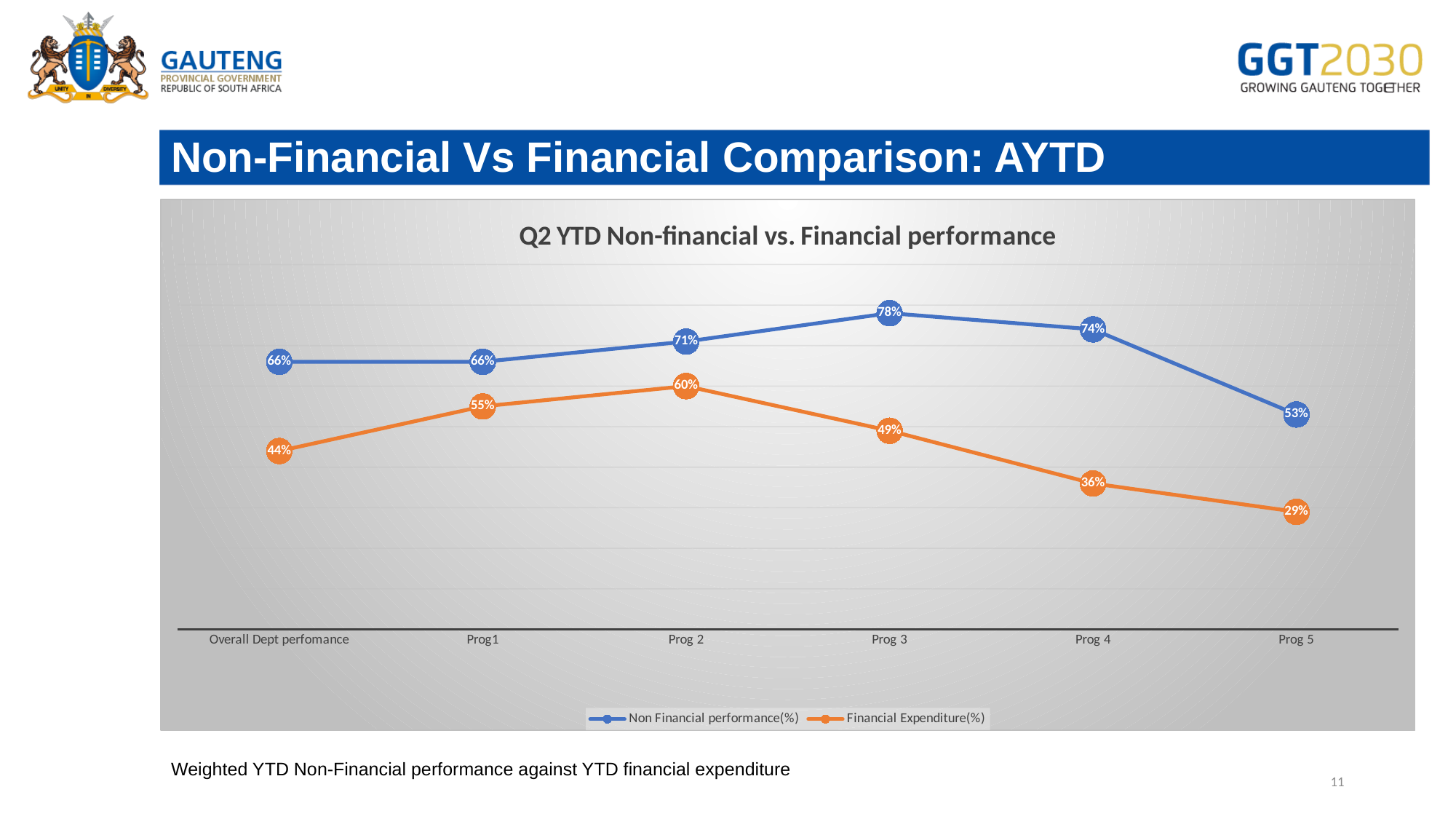
What is the Financial Expenditure(%) value for Prog 5? 29% What is the difference between Non Financial performance(%) and Financial Expenditure(%) for Prog 4? 38% How many series does the legend list? 2 Does the Financial Expenditure(%) series rise or fall from Prog 2 to Prog 5? Fall How many categories are shown on the x axis? 6 What is the Financial Expenditure(%) value for Overall Dept perfomance? 44% What is the Non Financial performance(%) value for Prog 3? 78% What is the title of the chart? Q2 YTD Non-financial vs. Financial performance Which category has the highest Non Financial performance(%)? Prog 3 Which is larger for Prog 2: Non Financial performance(%) or Financial Expenditure(%)? Non Financial performance(%) Which category has the lowest Financial Expenditure(%)? Prog 5 What kind of chart is shown on the slide? Line chart